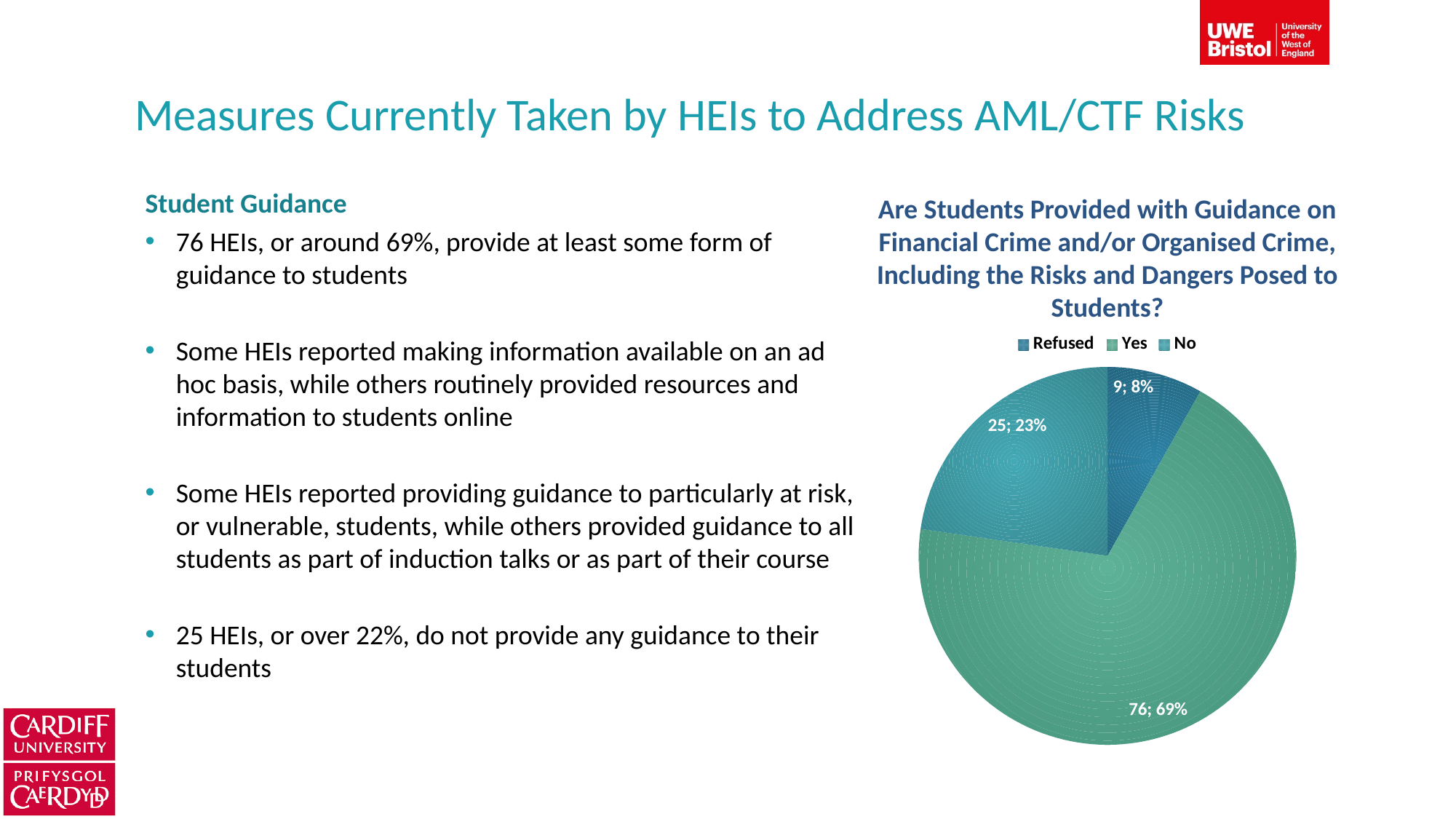
How many categories does the legend of the pie chart list? 3 What share of the pie does the Yes slice represent? 69% How many HEIs answered No to providing students with guidance on financial crime? 25 How many HEIs answered Yes to providing students with guidance on financial crime? 76 Which is larger, the number of HEIs that answered No or the number that Refused? No What share of the pie does the Refused slice represent? 8% How many more HEIs answered Yes than No? 51 Which response category has the smallest slice of the pie? Refused Which response category has the largest slice of the pie? Yes What share of the pie does the No slice represent? 23% How many HEIs refused to answer whether students are provided with guidance on financial crime? 9 What kind of chart is shown on the slide? Pie chart